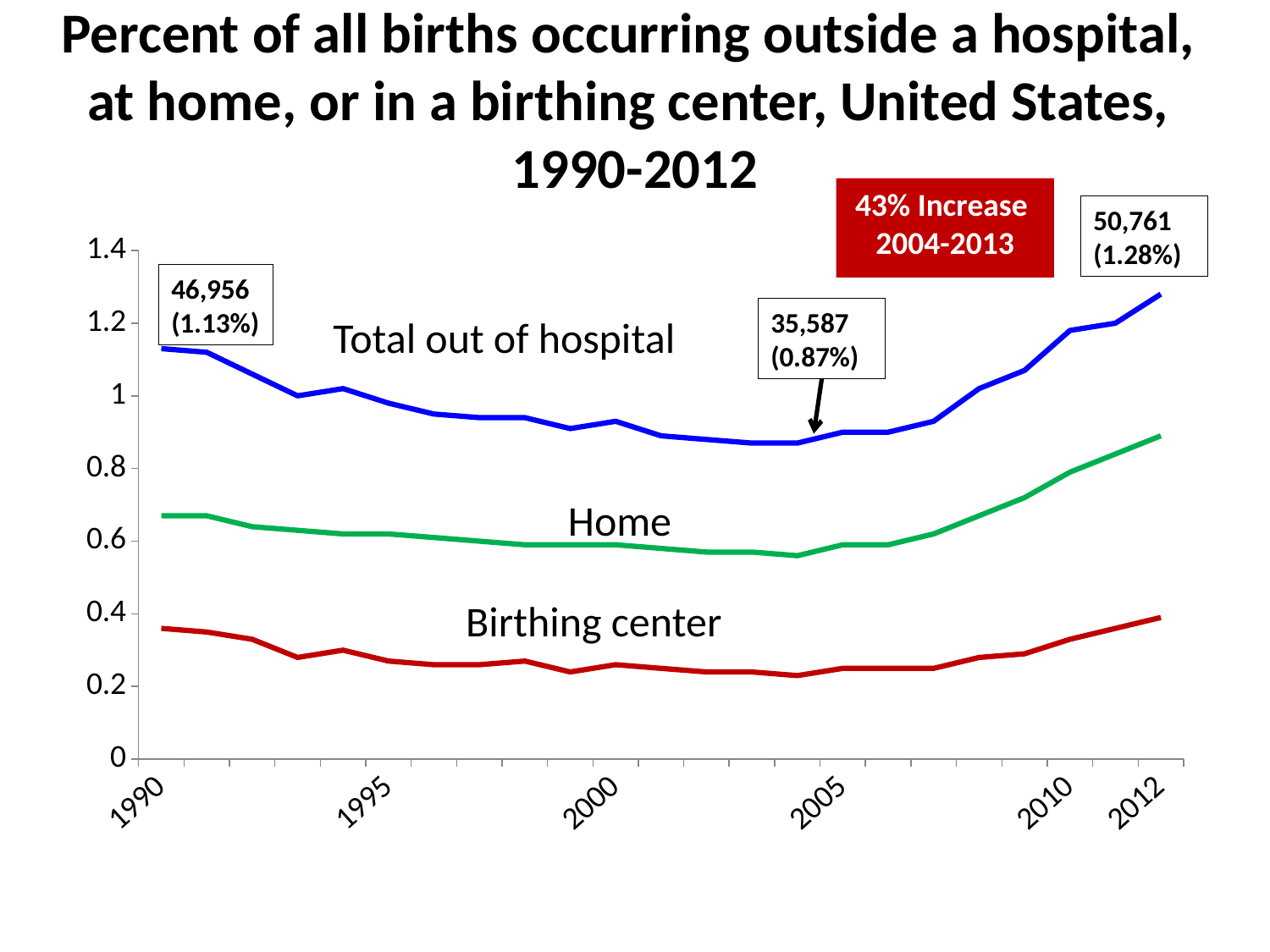
In 2012, which is larger: the Home value or the Birthing center value? Home Which series has the lowest values across the whole period? Birthing center By how many percentage points did the total out-of-hospital percent rise from 2004 (0.87%) to 2012 (1.28%)? 0.41 What is the difference between the number of out-of-hospital births labeled for 2012 and for 1990? 3,805 How many out-of-hospital births are labeled for 2012? 50,761 What percent increase does the red box report for 2004-2013? 43% Increase What percent of births occurred out of hospital in 2012, according to the data label? 1.28% What type of chart is shown on the slide? Line chart How many series (lines) are plotted on the chart? 3 How many out-of-hospital births are labeled for 2004? 35,587 What percent of births occurred out of hospital in 1990, according to the data label? 1.13% Is the Home value in 2012 greater or less than 0.8? greater